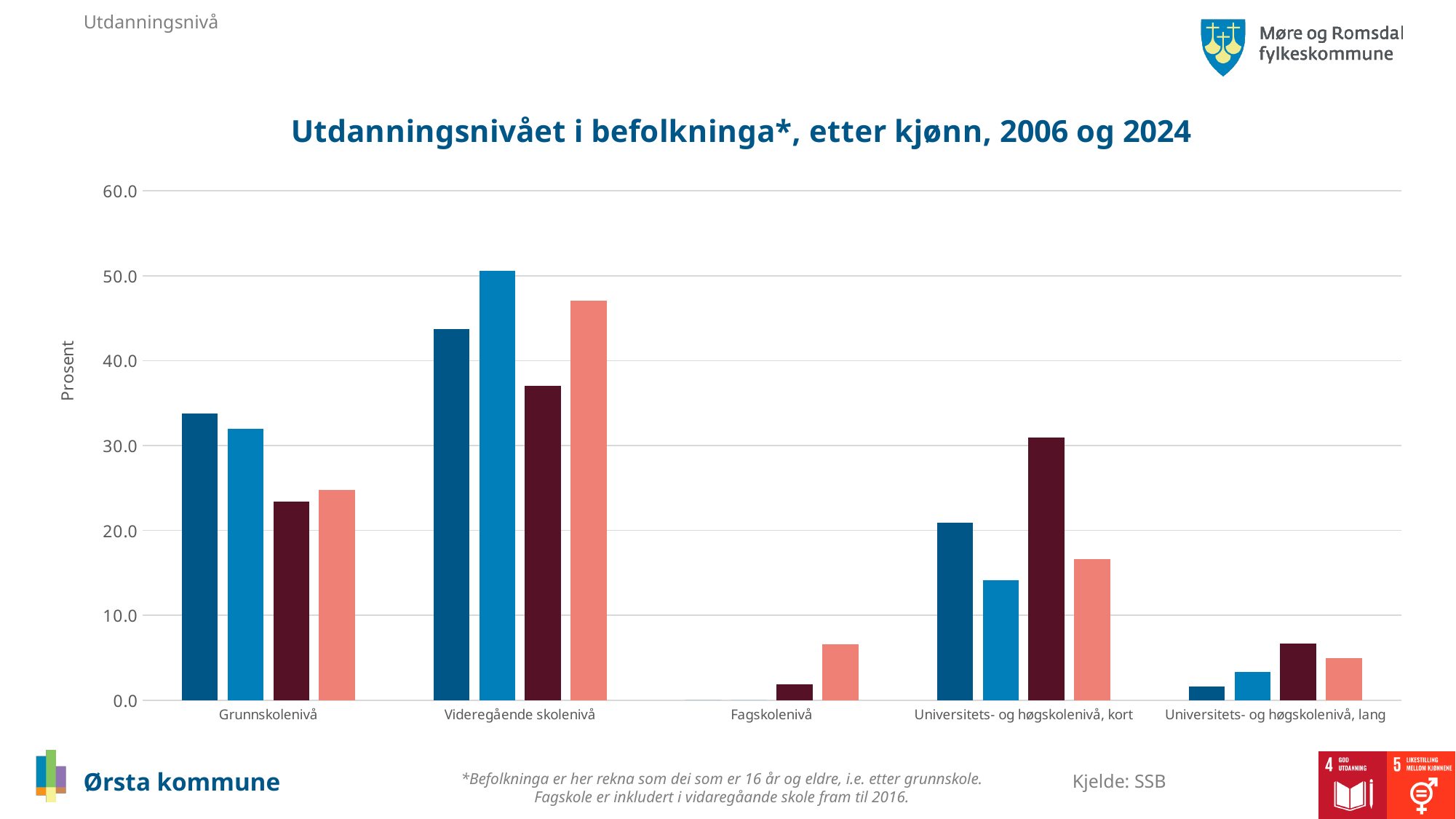
Is the tallest bar for Fagskolenivå greater or less than 10? less Is the tallest bar for Universitets- og høgskolenivå, lang greater or less than 10? less What kind of chart is shown on the slide? bar chart Which category contains the tallest bar in the chart? Videregående skolenivå Is the tallest bar for Universitets- og høgskolenivå, kort greater or less than 20? greater How many education-level categories are shown on the x axis? 5 Which category has the taller tallest bar: Grunnskolenivå or Universitets- og høgskolenivå, kort? Grunnskolenivå Which category has the lowest bars overall? Fagskolenivå What is the label on the y axis? Prosent What is the title of the chart? Utdanningsnivået i befolkninga*, etter kjønn, 2006 og 2024